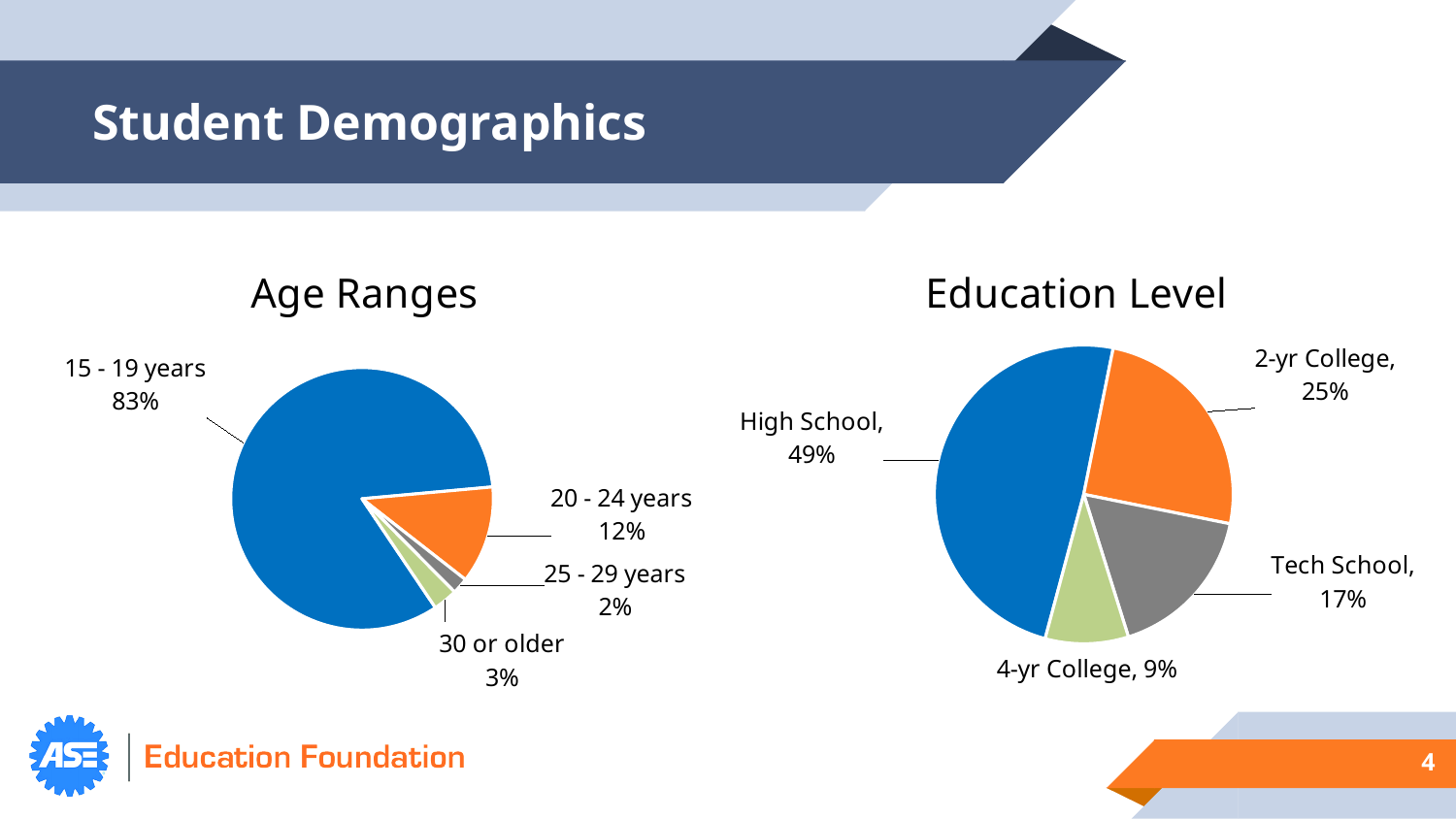
In the Education Level chart, what is the difference between the 2-yr College share and the Tech School share? 8% In the Age Ranges chart, what share of students are 15 - 19 years old? 83% In the Age Ranges chart, what percentage is shown for 20 - 24 years? 12% In the Education Level chart, how many education categories are shown? 4 In the Age Ranges chart, what is the difference between the 20 - 24 years share and the 30 or older share? 9% In the Age Ranges chart, how many age categories are shown? 4 In the Education Level chart, what percentage of students have a High School education level? 49% In the Education Level chart, what is the share for Tech School? 17% In the Age Ranges chart, which age range has the smallest share? 25 - 29 years What kind of chart is the Age Ranges chart? Pie chart In the Education Level chart, which education level has the largest share? High School In the Education Level chart, which is larger, 2-yr College or 4-yr College? 2-yr College